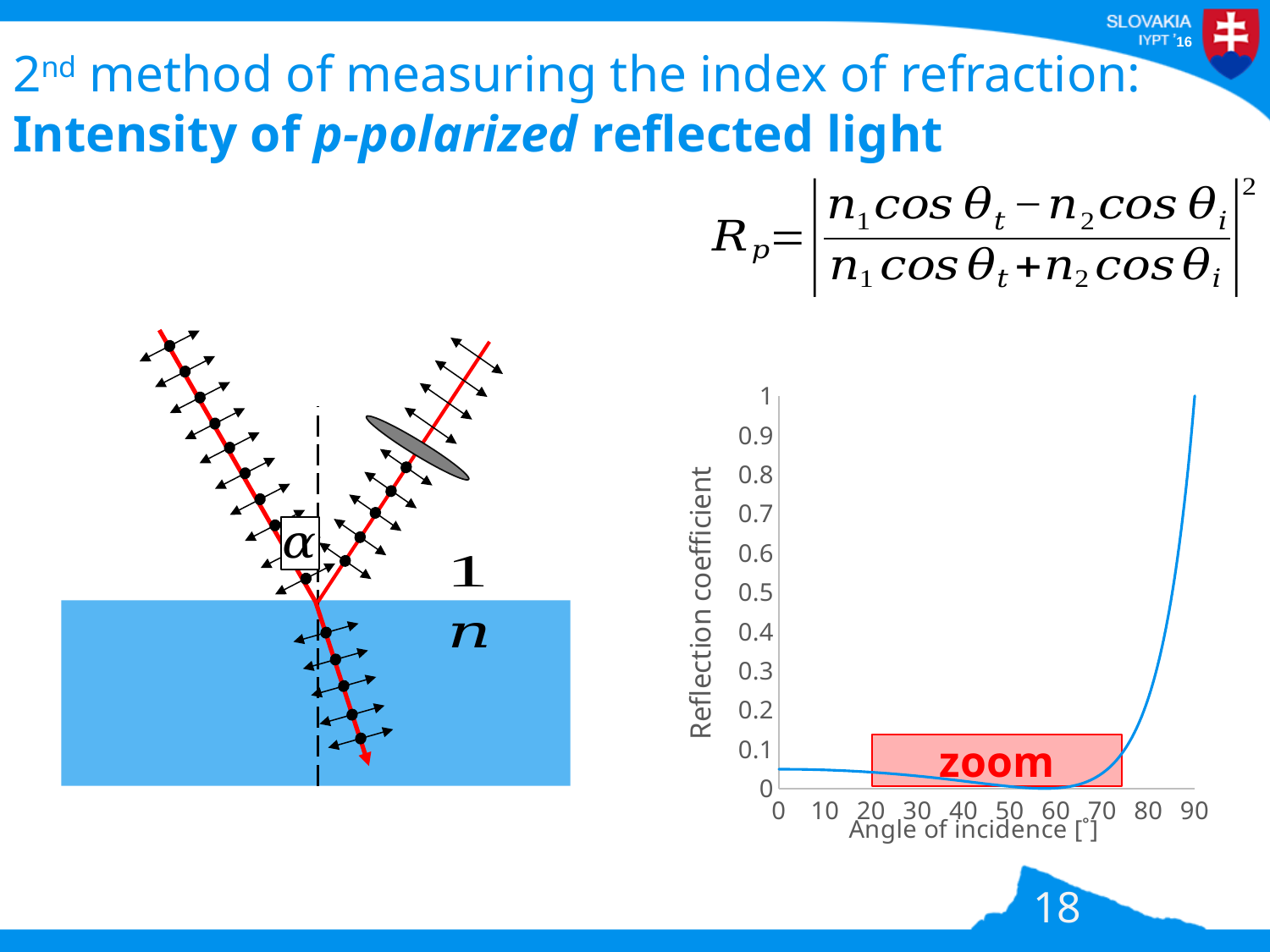
Does the reflection coefficient rise or fall as the angle of incidence increases from 0° to 40°? fall What is the label of the y axis of the chart? Reflection coefficient At which angle of incidence shown on the x axis does the curve reach its highest value? 90 Is the reflection coefficient at an angle of incidence of 90° greater or less than 0.9? greater What is the label of the x axis of the chart? Angle of incidence [°] What kind of chart is shown on the right of the slide? line chart What is the highest tick value shown on the y axis? 1 Is the reflection coefficient at an angle of incidence of 0° greater or less than 0.2? less How many lines are plotted on the chart? 1 Does the reflection coefficient rise or fall as the angle of incidence increases from 70° to 90°? rise Which is larger, the reflection coefficient at 10° or at 85°? 85° Is the reflection coefficient at an angle of incidence of 80° greater or less than 0.5? less